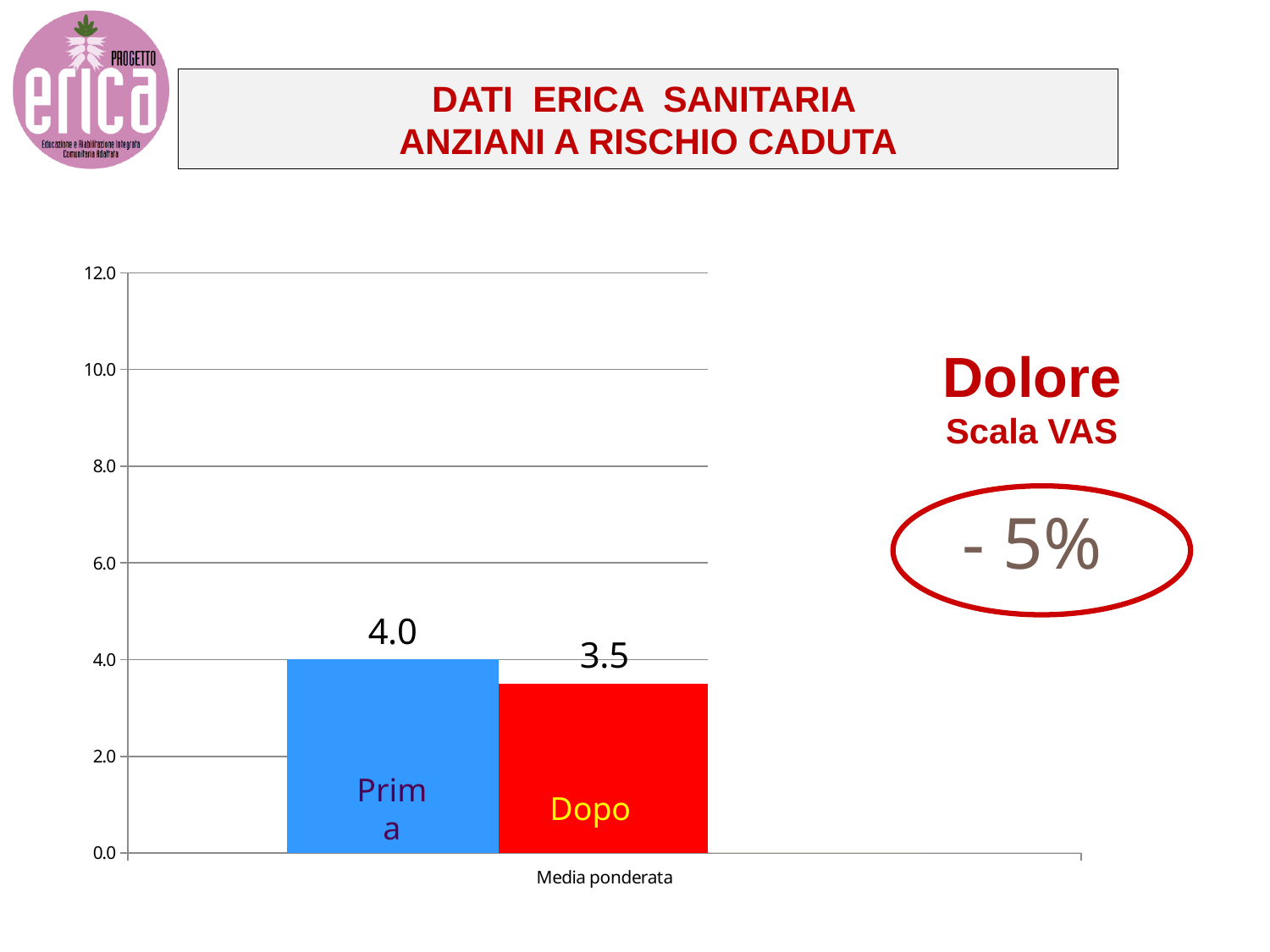
Which bar is higher, Prima or Dopo? Prima Is the value for Dopo greater or less than 2.0? greater What is the label on the x axis of the chart? Media ponderata Is the value for Prima greater or less than 6.0? less Which bar has the lowest value? Dopo What colour is the Dopo bar? red What kind of chart is shown on the slide? bar chart What is the value for Prima? 4.0 Do the values rise or fall from Prima to Dopo? fall How many bars are plotted in the chart? 2 What is the difference between the Prima and Dopo values? 0.5 What is the value for Dopo? 3.5